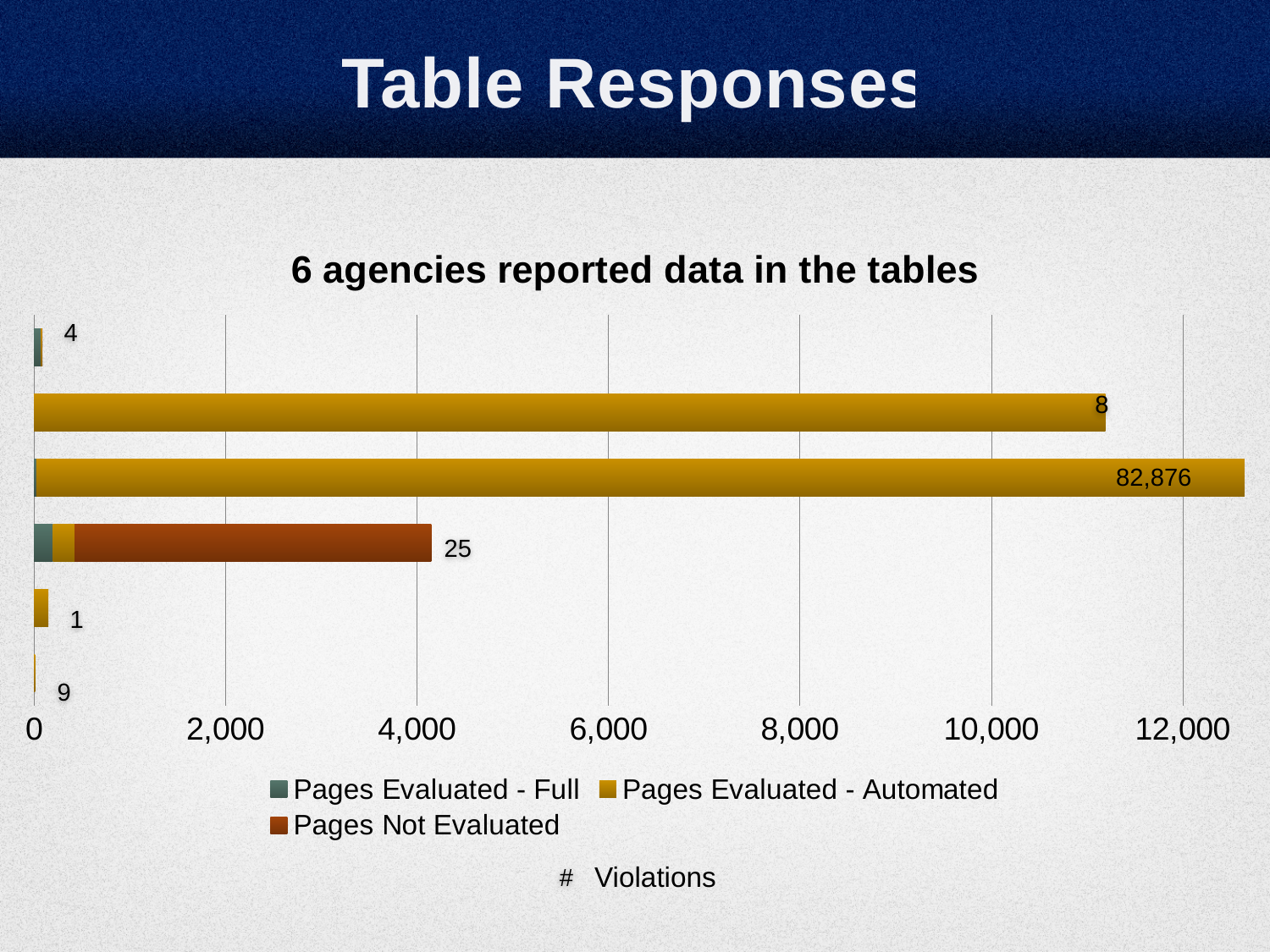
Is the total length of the second bar from the top greater or less than 10,000? greater Is the total length of the fourth bar from the top greater or less than 2,000? greater Is the total length of the top bar greater or less than 2,000? less How many bars are plotted in the chart? 6 What kind of chart is shown on the slide? bar chart What label is shown on the x axis below the legend? # Violations What is the title of the chart? 6 agencies reported data in the tables Which bar is the shortest? the bottom bar (labelled 9) How many series does the legend list? 3 Which bar extends furthest along the x axis? the third bar from the top (labelled 82,876) Which is longer, the second bar from the top or the fourth bar from the top? the second bar from the top